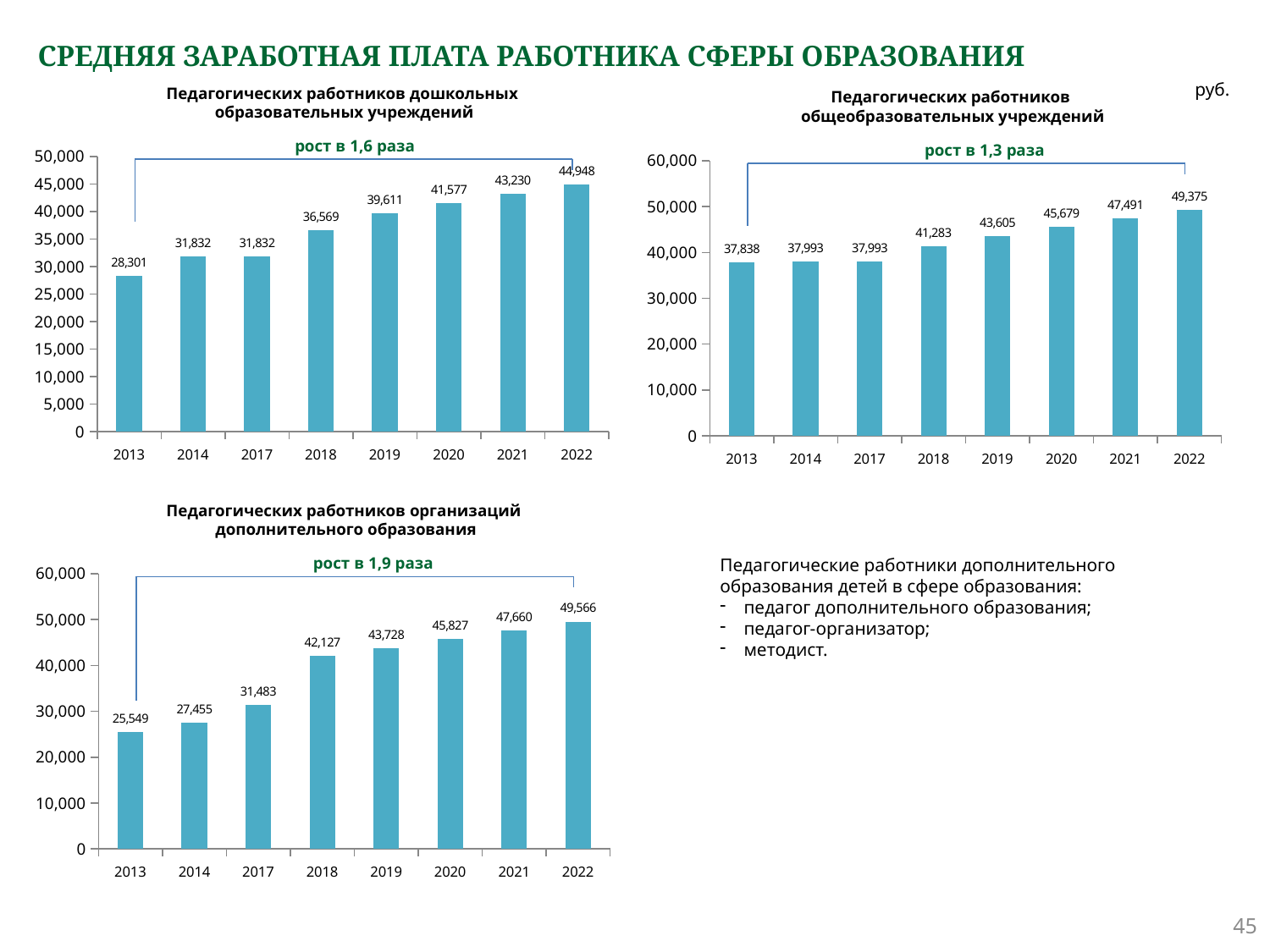
In the bottom-left chart (организаций дополнительного образования), which year has the lowest value? 2013 In the top-left chart (дошкольных образовательных учреждений), what is the difference between the 2022 value and the 2013 value? 16,647 In the top-right chart (общеобразовательных учреждений), which is larger: the value for 2018 or the value for 2020? 2020 How many years are shown on the x axis of the bottom-left chart (организаций дополнительного образования)? 8 In the top-right chart (общеобразовательных учреждений), is the value for 2013 greater or less than 40,000? less In the bottom-left chart (организаций дополнительного образования), what is the difference between the 2018 value and the 2017 value? 10,644 In the bottom-left chart (Педагогических работников организаций дополнительного образования), what is the value for 2018? 42,127 In the top-right chart (Педагогических работников общеобразовательных учреждений), what is the value for 2019? 43,605 In the top-left chart (дошкольных образовательных учреждений), which year has the highest value? 2022 What kind of chart is the top-right chart (общеобразовательных учреждений)? bar chart In the top-right chart (общеобразовательных учреждений), do the values generally rise or fall from 2013 to 2022? rise In the top-left chart (Педагогических работников дошкольных образовательных учреждений), what is the value for 2013? 28,301